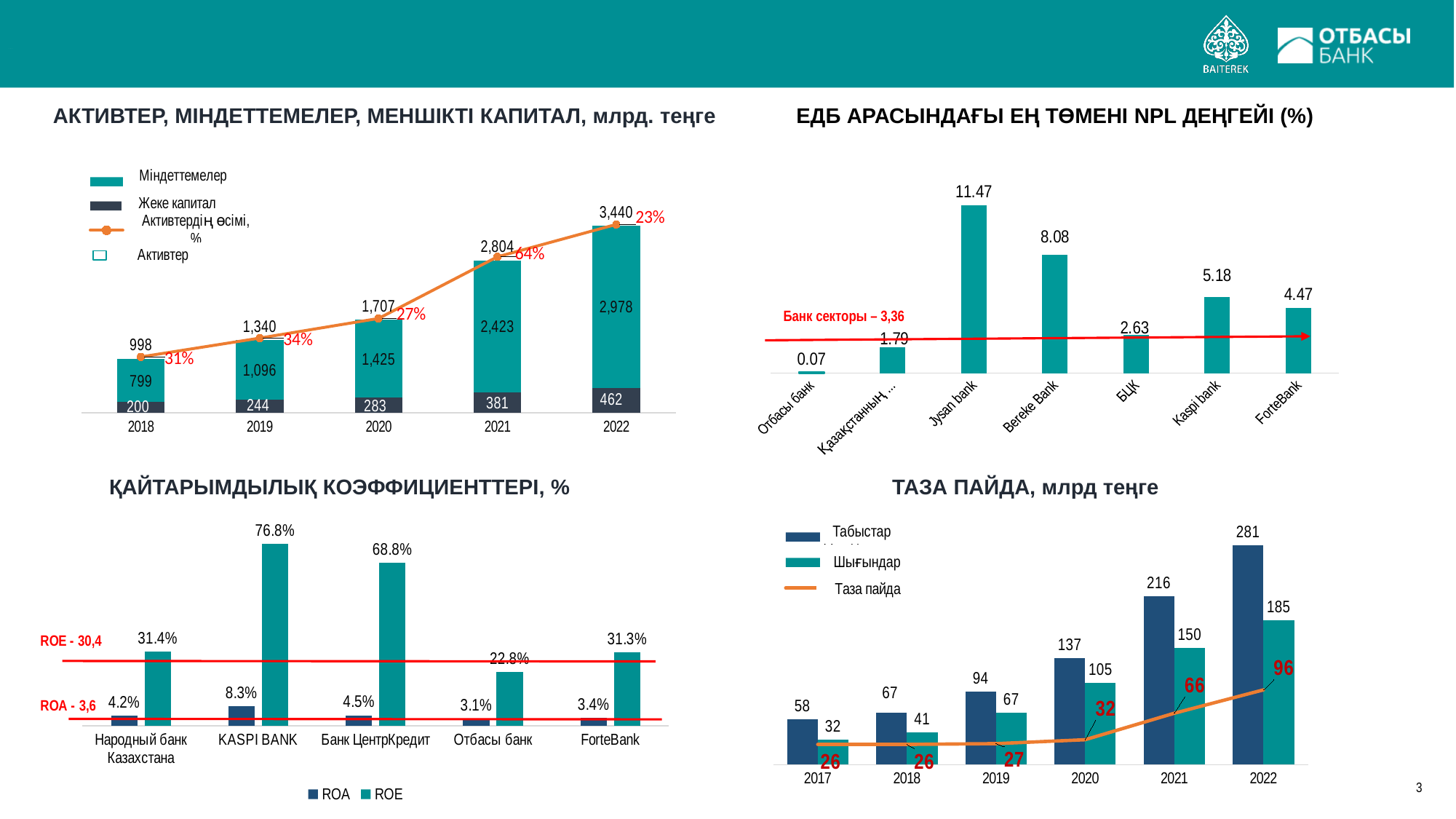
In the 'АКТИВТЕР, МІНДЕТТЕМЕЛЕР, МЕНШІКТІ КАПИТАЛ' chart, what is the difference between Жеке капитал in 2022 and 2018? 262 In the 'ТАЗА ПАЙДА, млрд теңге' chart, what is the Табыстар value for 2020? 137 In the 'ҚАЙТАРЫМДЫЛЫҚ КОЭФФИЦИЕНТТЕРІ, %' chart, how many series does the legend list? 2 In the 'АКТИВТЕР, МІНДЕТТЕМЕЛЕР, МЕНШІКТІ КАПИТАЛ' chart, what is the total Активтер value for 2022? 3,440 In the 'ЕДБ АРАСЫНДАҒЫ ЕҢ ТӨМЕНІ NPL ДЕҢГЕЙІ (%)' chart, which bank has the lowest NPL level? Отбасы банк In the 'ЕДБ АРАСЫНДАҒЫ ЕҢ ТӨМЕНІ NPL ДЕҢГЕЙІ (%)' chart, how many banks are shown? 7 In the 'ЕДБ АРАСЫНДАҒЫ ЕҢ ТӨМЕНІ NPL ДЕҢГЕЙІ (%)' chart, what is the NPL value for Jysan bank? 11.47 In the 'ТАЗА ПАЙДА, млрд теңге' chart, does the Таза пайда line rise or fall from 2017 to 2022? rise In the 'ҚАЙТАРЫМДЫЛЫҚ КОЭФФИЦИЕНТТЕРІ, %' chart, what is the ROE for KASPI BANK? 76.8% In the 'ҚАЙТАРЫМДЫЛЫҚ КОЭФФИЦИЕНТТЕРІ, %' chart, which bank has the lowest ROA? Отбасы банк In the 'АКТИВТЕР, МІНДЕТТЕМЕЛЕР, МЕНШІКТІ КАПИТАЛ' chart, what is the Міндеттемелер value for 2021? 2,423 In the 'АКТИВТЕР, МІНДЕТТЕМЕЛЕР, МЕНШІКТІ КАПИТАЛ' chart, in which year was the asset growth percentage highest? 2021